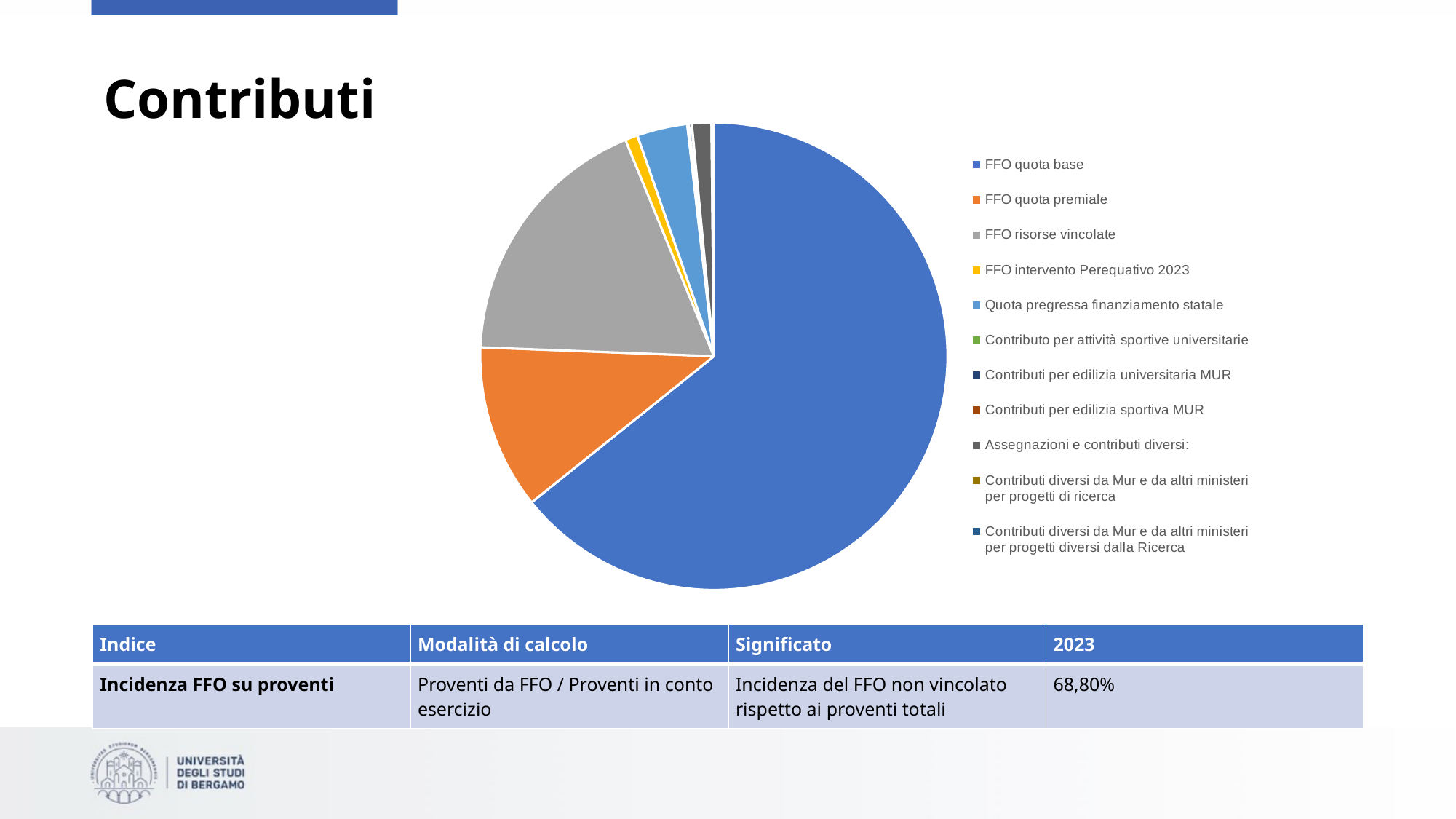
Does FFO quota base account for more or less than half of the pie? more What colour is the FFO quota premiale slice in the pie chart? orange How many entries does the legend of the pie chart list? 11 What is the title of the slide containing the pie chart? Contributi Which slice is larger, FFO quota premiale or FFO intervento Perequativo 2023? FFO quota premiale Which slice is larger, FFO quota base or FFO quota premiale? FFO quota base Which slice is larger, Quota pregressa finanziamento statale or FFO intervento Perequativo 2023? Quota pregressa finanziamento statale Which category has the largest slice in the pie chart? FFO quota base What kind of chart is shown on the slide? pie chart